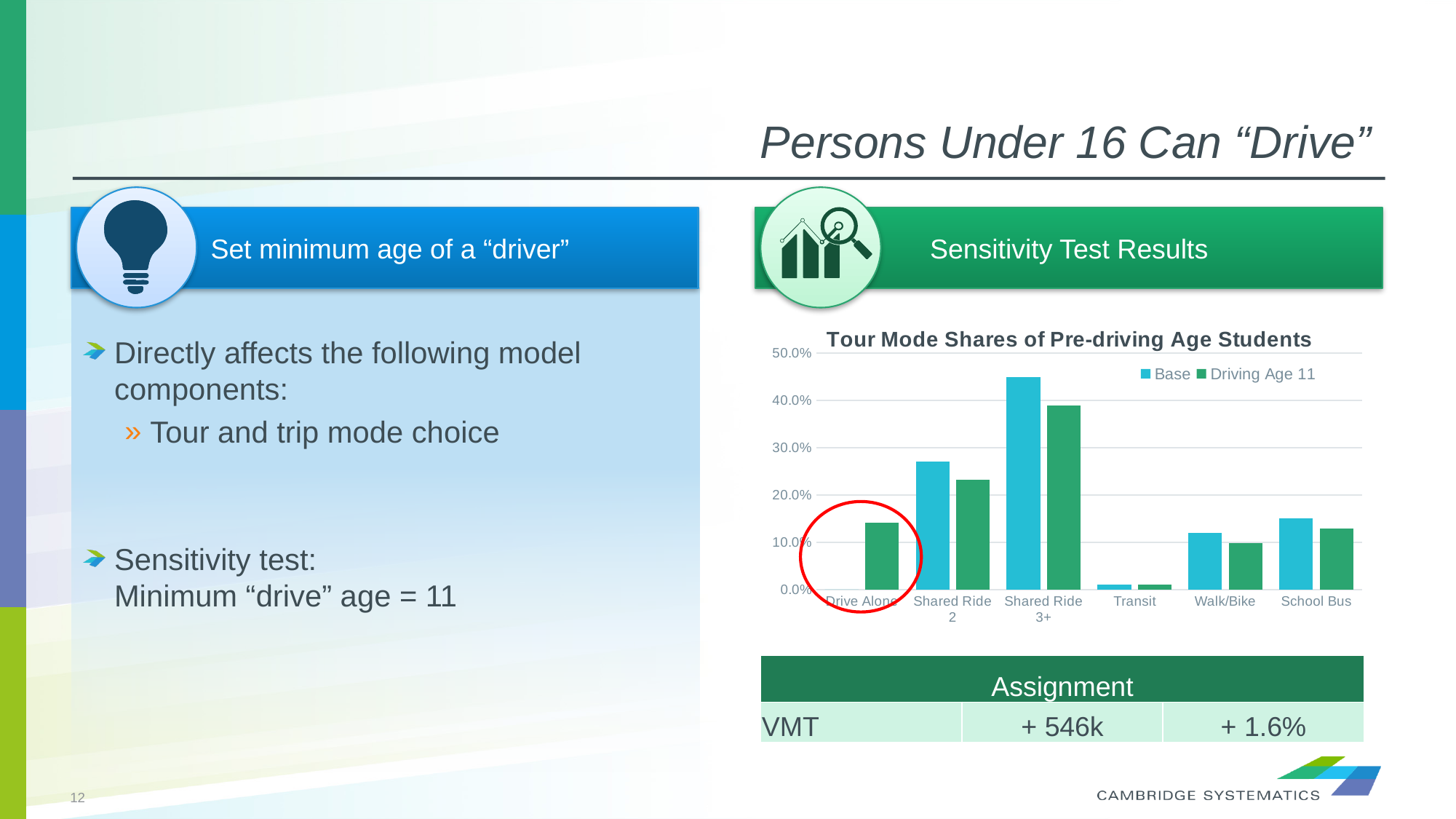
Is the Base value for Shared Ride 3+ greater or less than 40.0%? greater What kind of chart is shown under "Sensitivity Test Results"? Bar chart Which category has the lowest Driving Age 11 value in the chart? Transit How many series does the chart's legend list? 2 How many tour mode categories are shown on the x axis of the chart? 6 For Drive Alone, which series has the larger value, Base or Driving Age 11? Driving Age 11 What are the two series named in the chart's legend? Base and Driving Age 11 Which category has the highest Base value in the chart? Shared Ride 3+ Is the Base value for Transit greater or less than 10.0%? less What is the title of the chart on the slide? Tour Mode Shares of Pre-driving Age Students Is the Driving Age 11 value for Drive Alone greater or less than 10.0%? greater For Shared Ride 2, which series has the larger value, Base or Driving Age 11? Base